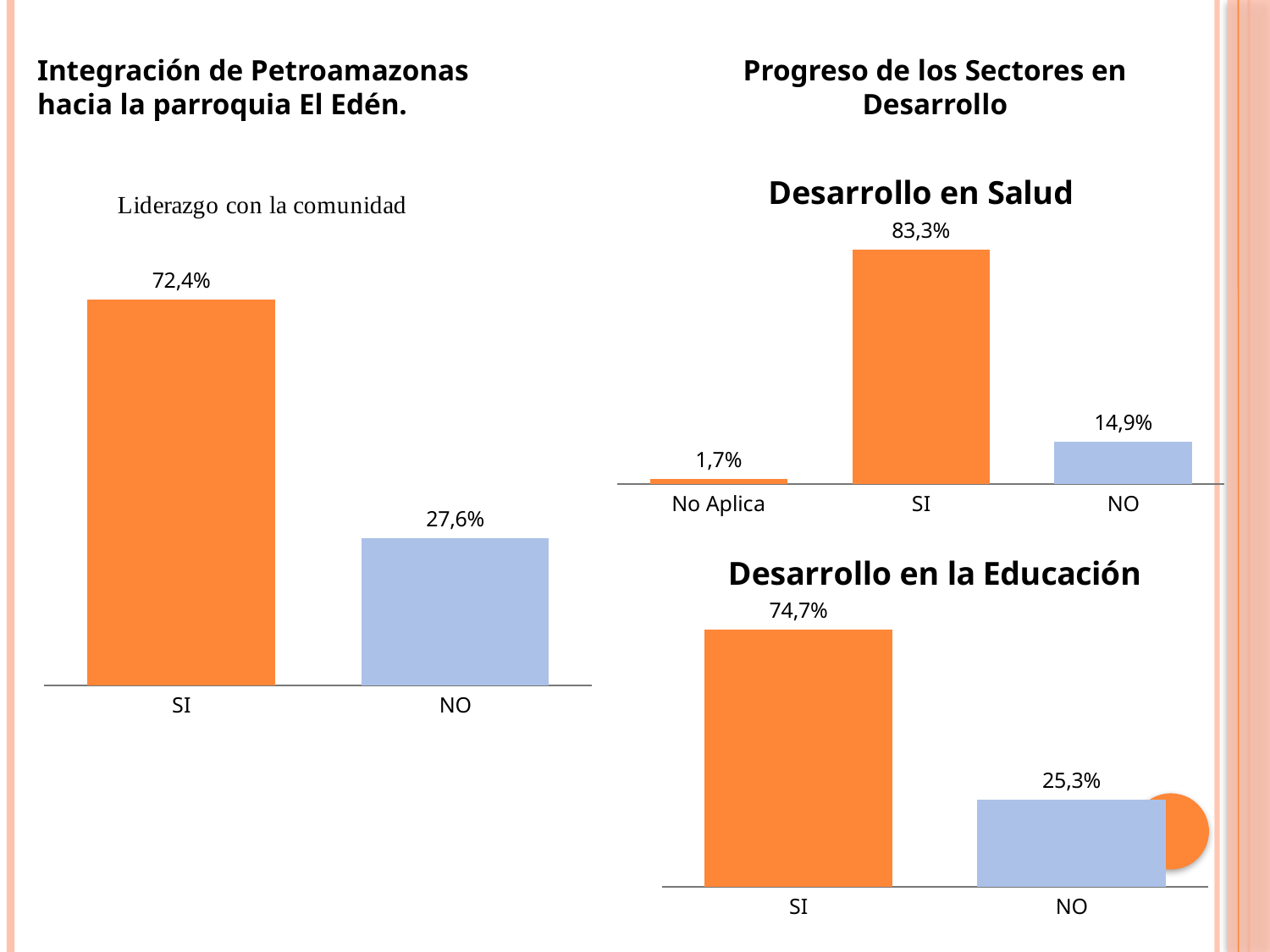
In the 'Desarrollo en la Educación' chart, which category has the highest value? SI In the 'Desarrollo en la Educación' chart, which is larger, SI or NO? SI In the 'Desarrollo en Salud' chart, what is the difference between the SI and NO values? 68,4% What kind of chart is the 'Liderazgo con la comunidad' chart? Bar chart In the 'Desarrollo en Salud' chart, how many categories are shown? 3 In the 'Desarrollo en Salud' chart, what is the value for No Aplica? 1,7% In the 'Liderazgo con la comunidad' chart, what is the value for NO? 27,6% In the 'Liderazgo con la comunidad' chart, what is the difference between the SI and NO values? 44,8% In the 'Desarrollo en Salud' chart, what is the value for SI? 83,3% In the 'Desarrollo en Salud' chart, which category has the lowest value? No Aplica In the 'Desarrollo en la Educación' chart, what is the value for NO? 25,3% In the 'Liderazgo con la comunidad' chart, what is the value for SI? 72,4%